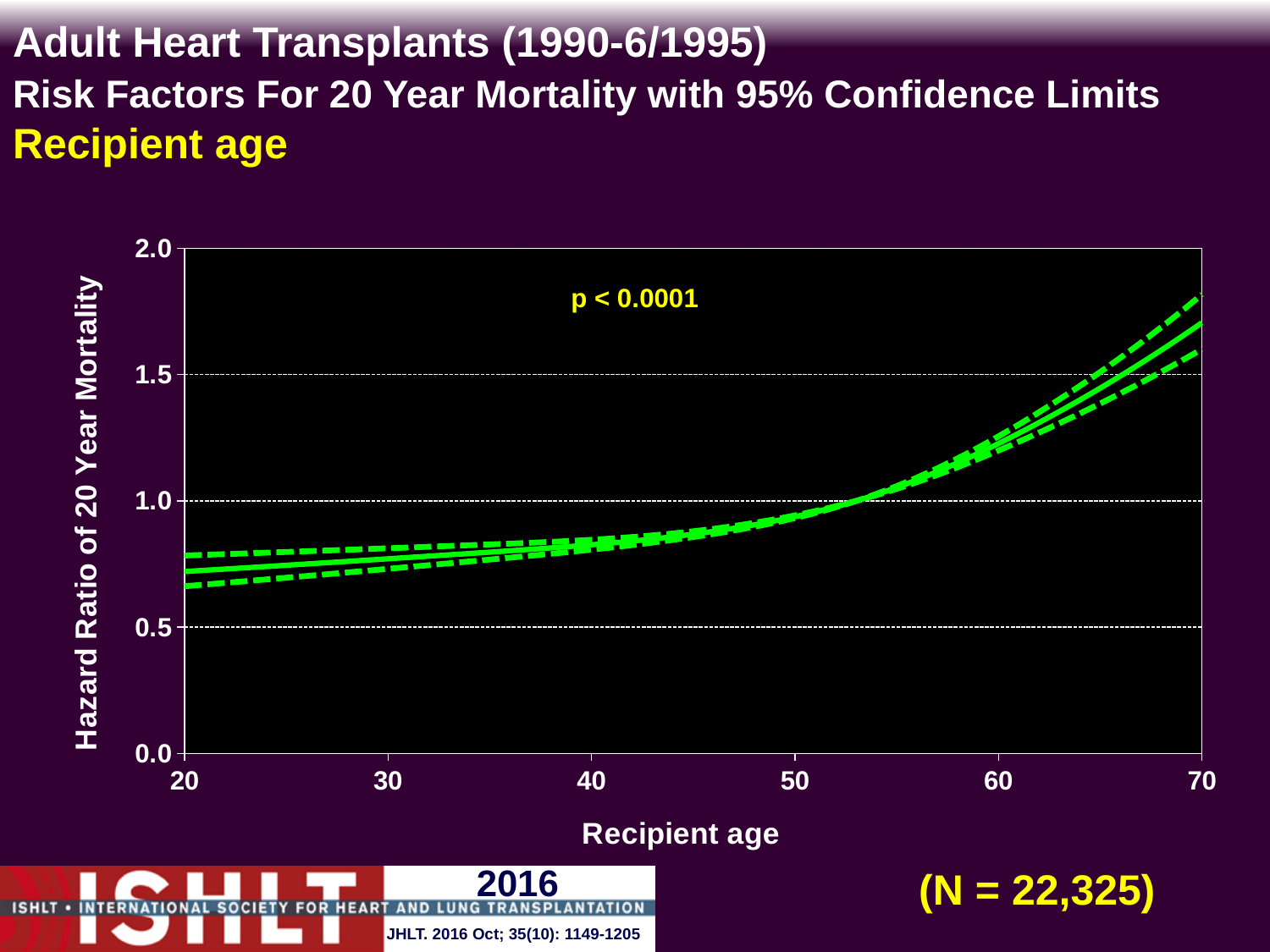
Which recipient age shown on the x axis has the higher hazard ratio, 20 or 70? 70 Is the hazard ratio at recipient age 40 greater or less than 1.0? less What is the label of the y axis? Hazard Ratio of 20 Year Mortality Is the hazard ratio at recipient age 30 greater or less than 0.5? greater Is the hazard ratio at recipient age 20 greater or less than 1.0? less What p-value is printed on the chart? p < 0.0001 At which recipient age on the x axis is the hazard ratio lowest? 20 Does the hazard ratio of 20 year mortality rise or fall as recipient age increases from 20 to 70? rise At which recipient age on the x axis is the hazard ratio highest? 70 What kind of chart is shown on the slide? line chart